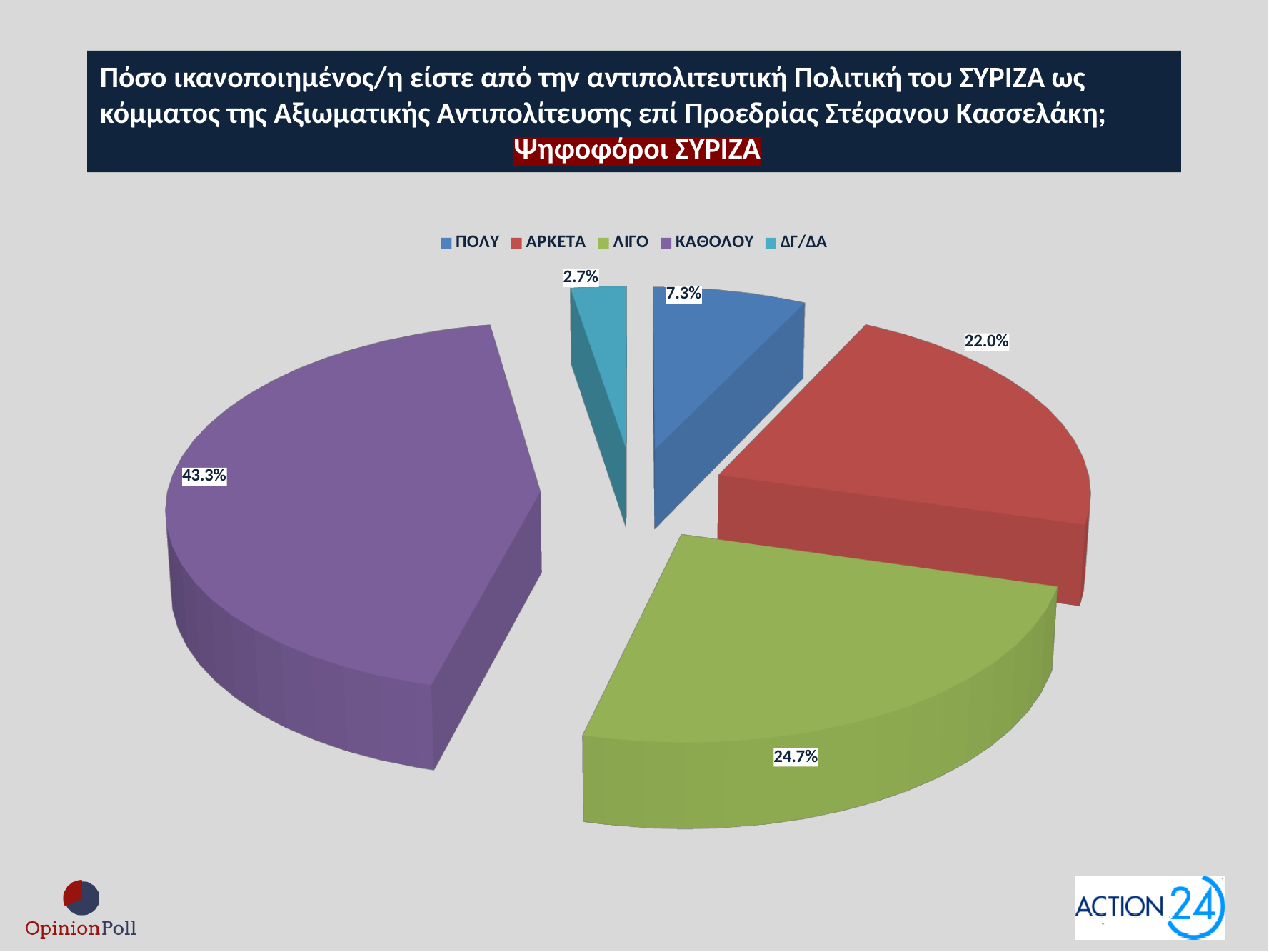
What percentage of ΣΥΡΙΖΑ voters answered ΔΓ/ΔΑ? 2.7% What percentage of ΣΥΡΙΖΑ voters answered ΚΑΘΟΛΟΥ? 43.3% What kind of chart is shown on the slide? pie chart What percentage of ΣΥΡΙΖΑ voters answered ΛΙΓΟ? 24.7% Which response has the smallest share of the pie? ΔΓ/ΔΑ What is the difference in percentage points between ΚΑΘΟΛΟΥ and ΛΙΓΟ? 18.6 What colour is the ΚΑΘΟΛΟΥ slice? purple What percentage of ΣΥΡΙΖΑ voters answered ΑΡΚΕΤΑ? 22.0% How many response categories does the legend list? 5 What percentage of ΣΥΡΙΖΑ voters answered ΠΟΛΥ? 7.3% Which response has the largest share of the pie? ΚΑΘΟΛΟΥ Which is larger, the share for ΑΡΚΕΤΑ or the share for ΛΙΓΟ? ΛΙΓΟ